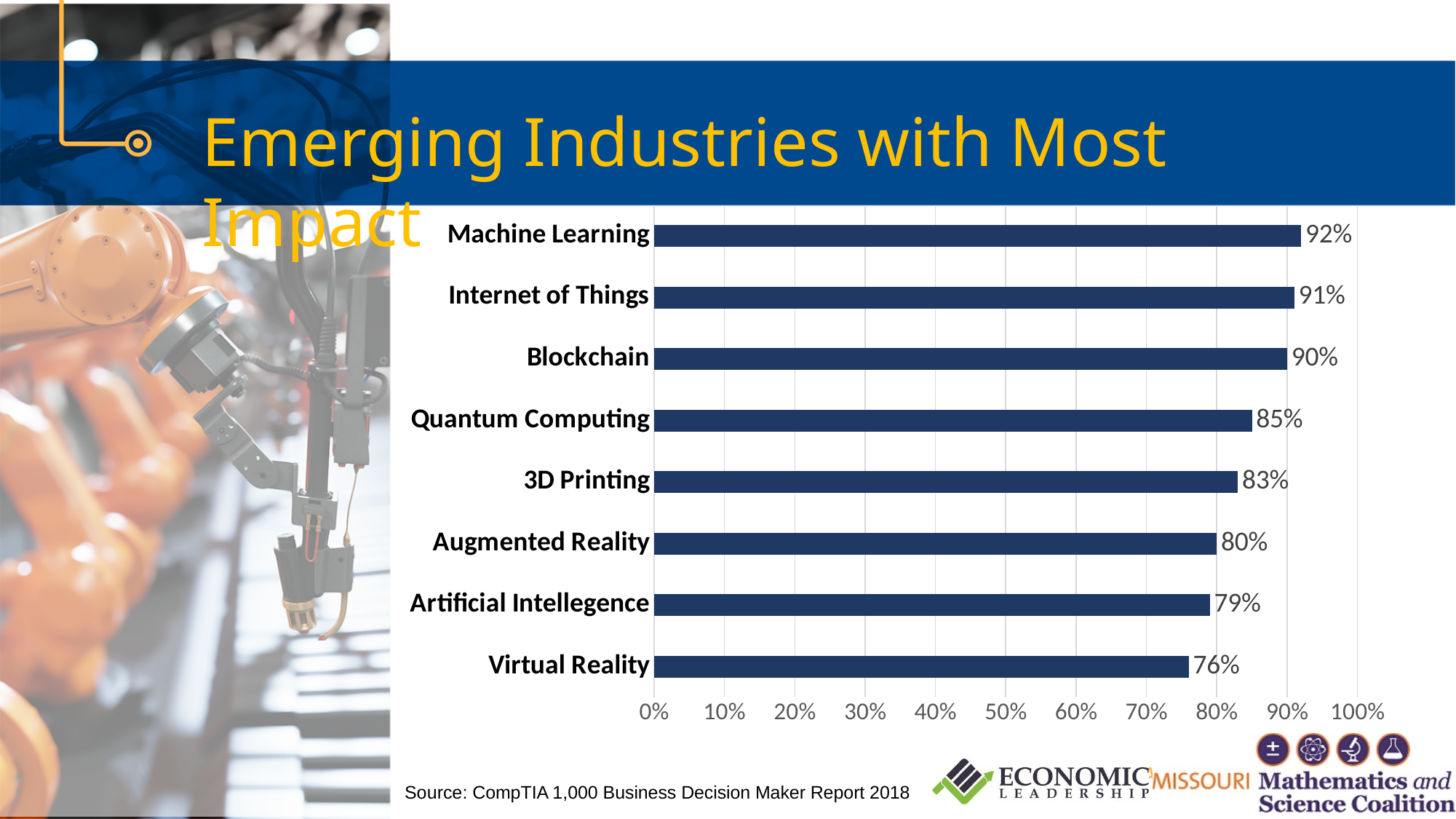
What kind of chart is shown on the slide? Bar chart What is the value for Virtual Reality? 76% How many categories are shown in the chart? 8 Which category has the lowest value? Virtual Reality What is the value for Quantum Computing? 85% Which category has the highest value? Machine Learning What is the value for Augmented Reality? 80% What is the difference between the values for Machine Learning and Virtual Reality? 16% What is the source cited for the chart? CompTIA 1,000 Business Decision Maker Report 2018 What is the difference between the values for Blockchain and 3D Printing? 7% What is the value for Machine Learning? 92% Which is larger, the value for Internet of Things or the value for Artificial Intellegence? Internet of Things